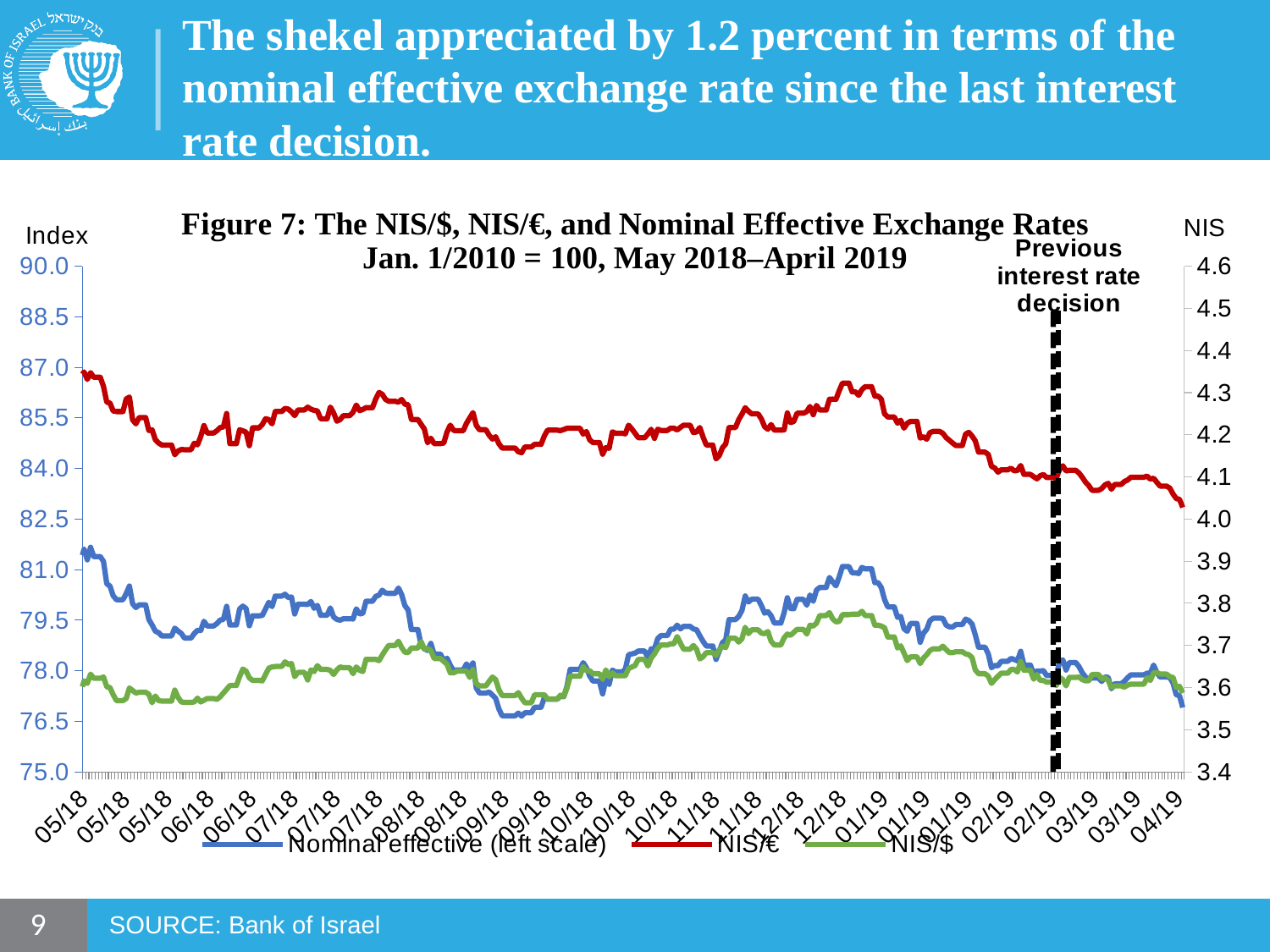
Is the Nominal effective index at the start of the period (05/18) greater or less than 81.0? greater Is the NIS/€ value at the end of the period (04/19) greater or less than 4.1? less Does the NIS/€ series rise or fall overall from 05/18 to 04/19? fall Is the Nominal effective index at its low point around 09/18 greater or less than 78.0? less What is the highest tick value shown on the right-hand (NIS) axis of Figure 7? 4.6 Which series is higher throughout Figure 7, NIS/€ or NIS/$? NIS/€ Which series in Figure 7 is plotted on the left scale? Nominal effective What does the vertical dashed black line in Figure 7 mark? Previous interest rate decision How many series does the legend of Figure 7 list? 3 What kind of chart is Figure 7? line chart